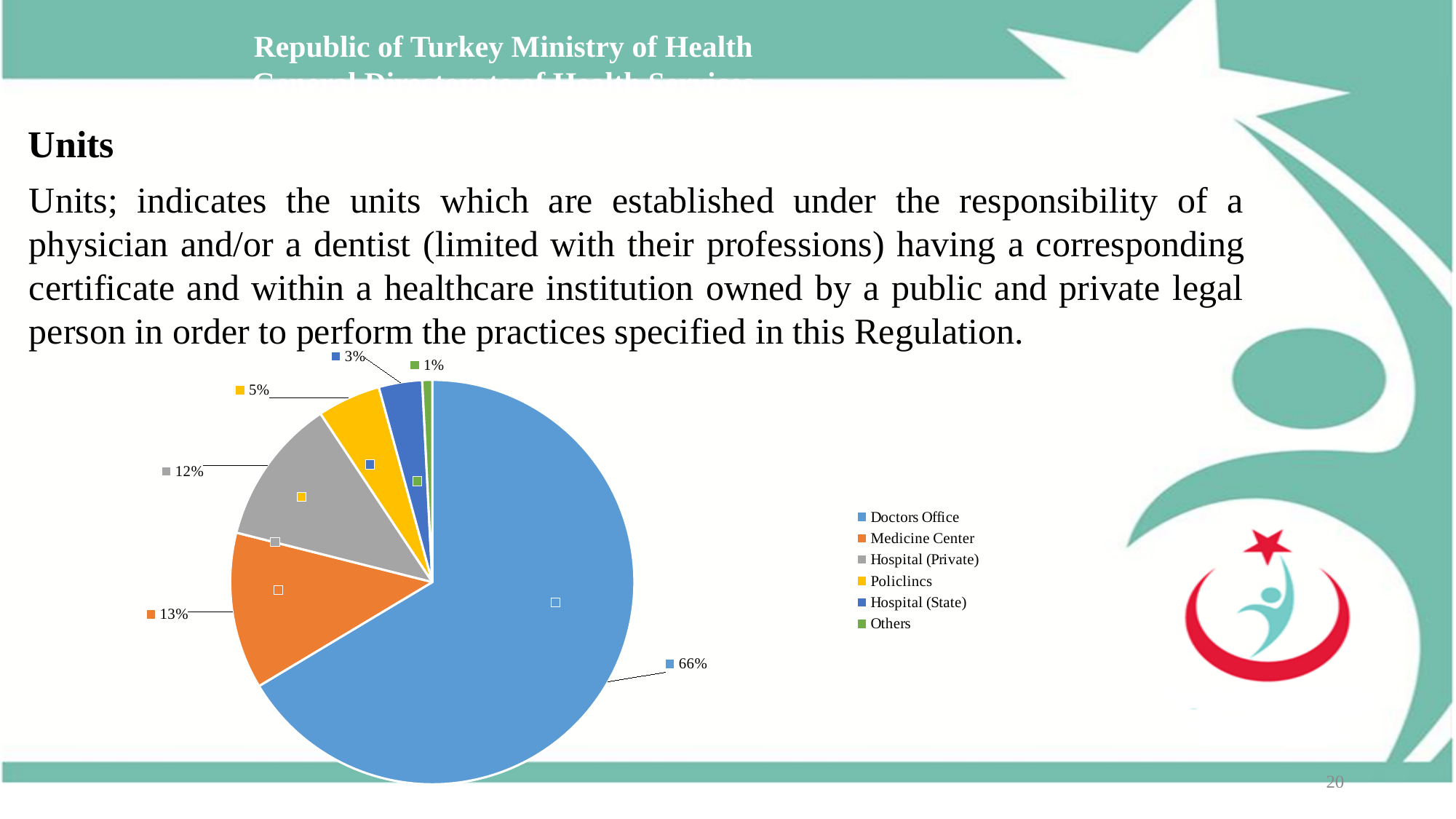
What kind of chart is shown on the slide? pie chart Which is larger, the share for Policlincs or the share for Hospital (State)? Policlincs What is the value shown for Policlincs? 5% Which category has the smallest slice of the pie? Others What is the value shown for Hospital (Private)? 12% What is the difference between the shares of Doctors Office and Medicine Center? 53% What is the value shown for Medicine Center? 13% Which category has the largest slice of the pie? Doctors Office What is the value shown for Hospital (State)? 3% What share of the pie does Doctors Office account for? 66% What colour is the slice for Hospital (Private)? grey How many categories does the pie chart show? 6